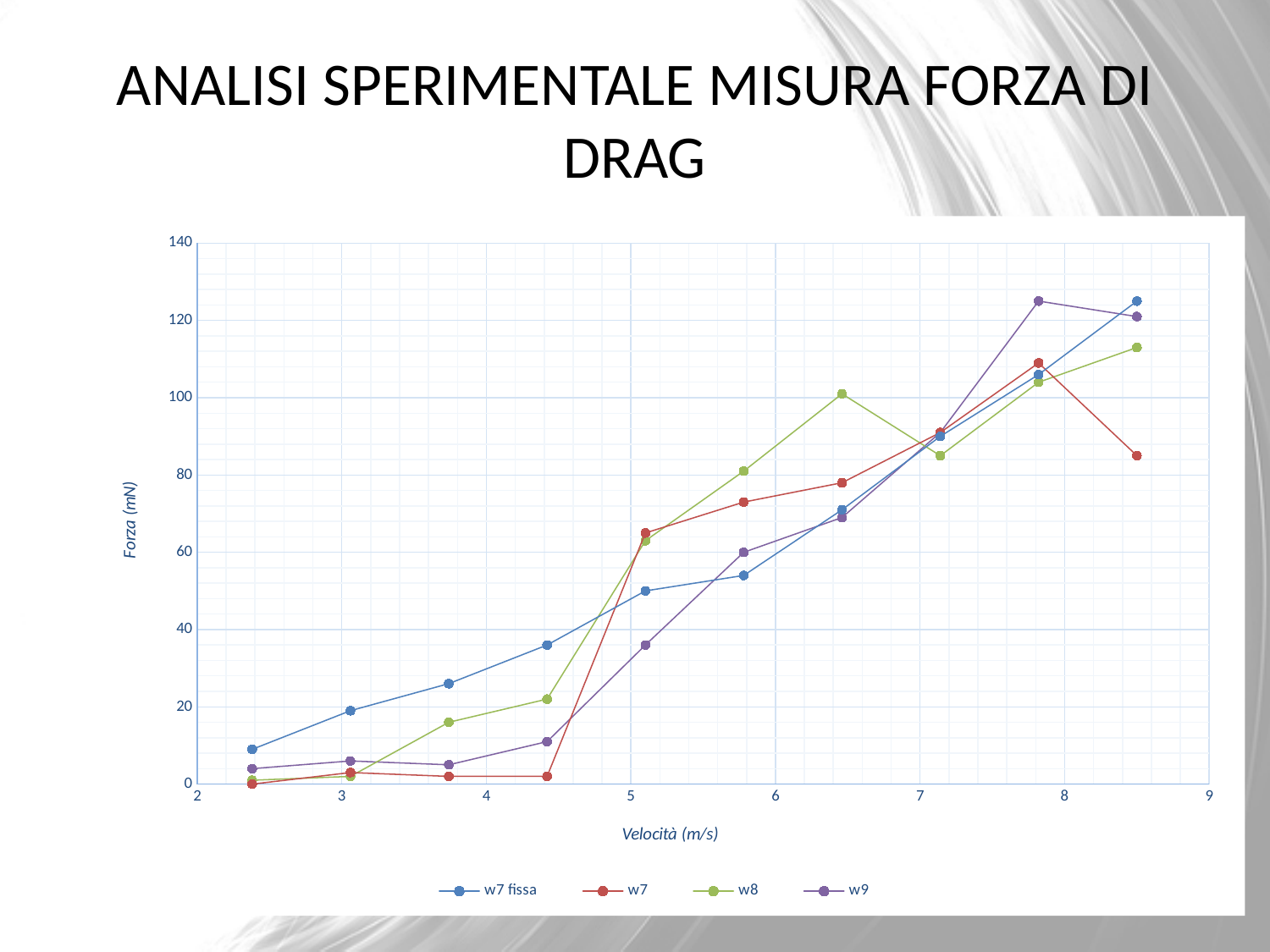
What are the names of the series in the legend? w7 fissa, w7, w8, w9 At the highest velocity plotted, which series has the larger value, w7 fissa or w7? w7 fissa Does the w7 fissa series generally rise or fall as velocity increases? rise How many data points does the w7 fissa series have? 10 At the highest velocity plotted, which series has the lowest force value? w7 Is the value of the w7 series at its highest velocity greater or less than 100? less What kind of chart is shown on the slide? line chart How many series does the legend list? 4 What is the label of the vertical axis? Forza (mN) Is the value of the w7 fissa series at its highest velocity greater or less than 120? greater Is the value of the w8 series at its highest velocity greater or less than 100? greater